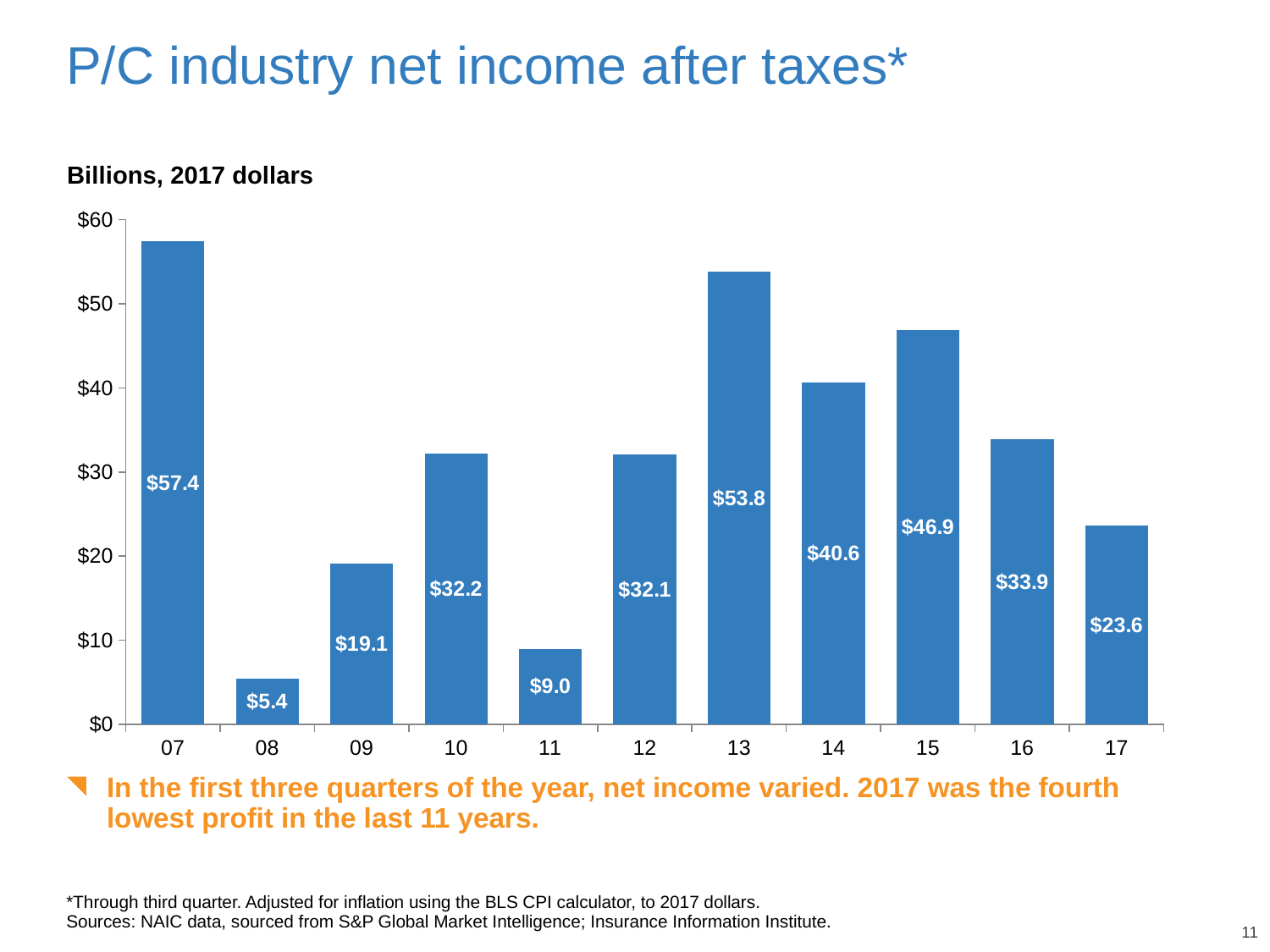
Do the values rise or fall from 2013 to 2017? fall Which year has the lowest net income after taxes? 08 What is the P/C industry net income after taxes for 2013? $53.8 What is the difference between the values for 2015 and 2014? $6.3 Which year has the larger value, 2009 or 2016? 16 What is the difference between the values for 2007 and 2017? $33.8 What kind of chart is shown on the slide? bar chart Is the value for 2011 greater or less than $10? less What is the value shown for 2017? $23.6 What is the value shown for 2008? $5.4 How many years are shown on the x axis? 11 Which year has the highest net income after taxes? 07